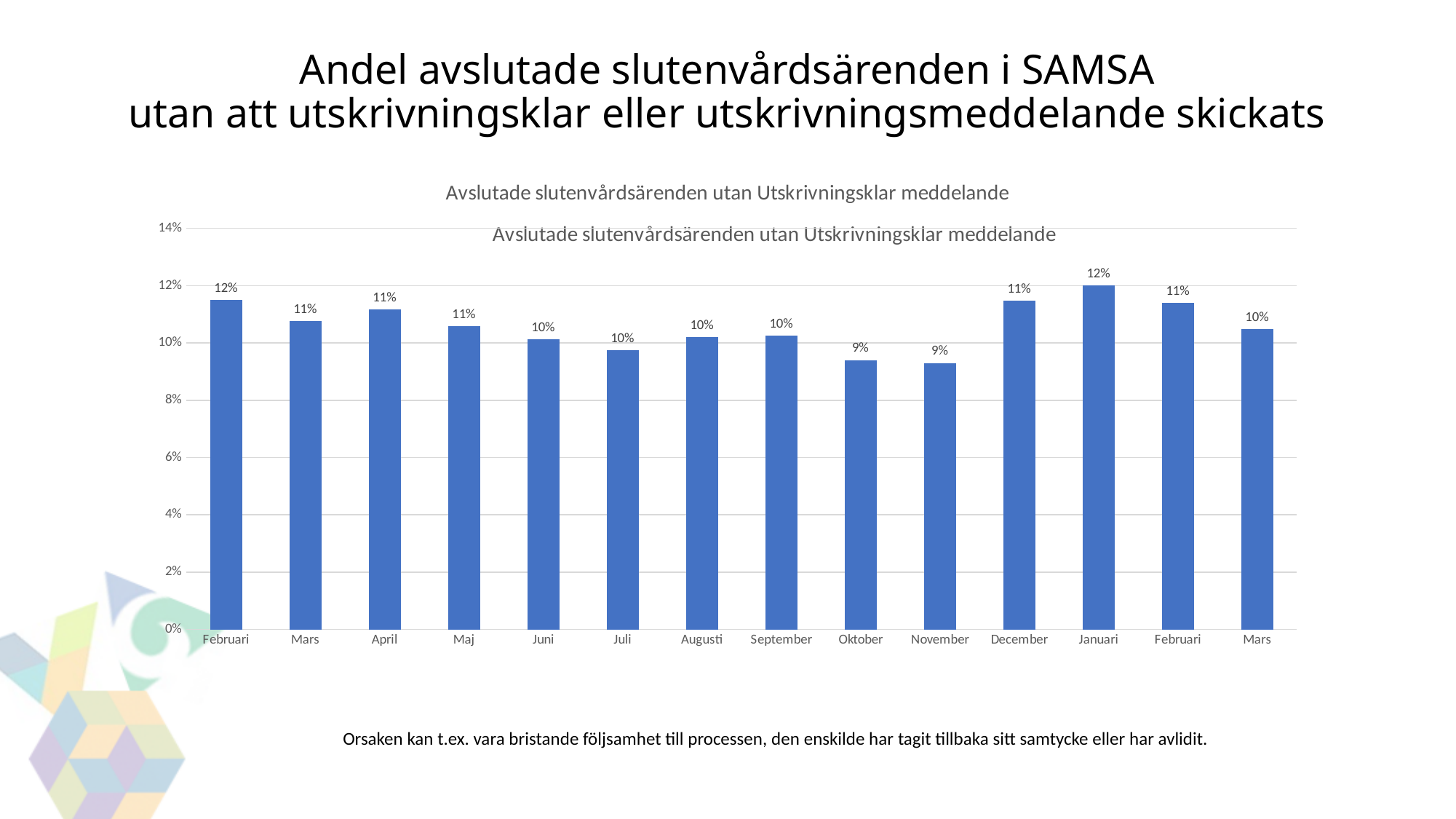
From Juni to November, do the values generally rise or fall? fall Which is larger, the value for December or the value for November? December Is the value for November greater or less than 10%? less What is the value for Januari? 12% What is the value for Oktober? 9% How many bars are shown in the chart? 14 What is the value for April? 11% What is the value for September? 10% What kind of chart is shown on the slide? bar chart Is the value for Juni greater or less than 8%? greater What colour are the bars in the chart? blue What is the difference between the values for Januari and Oktober? 3%